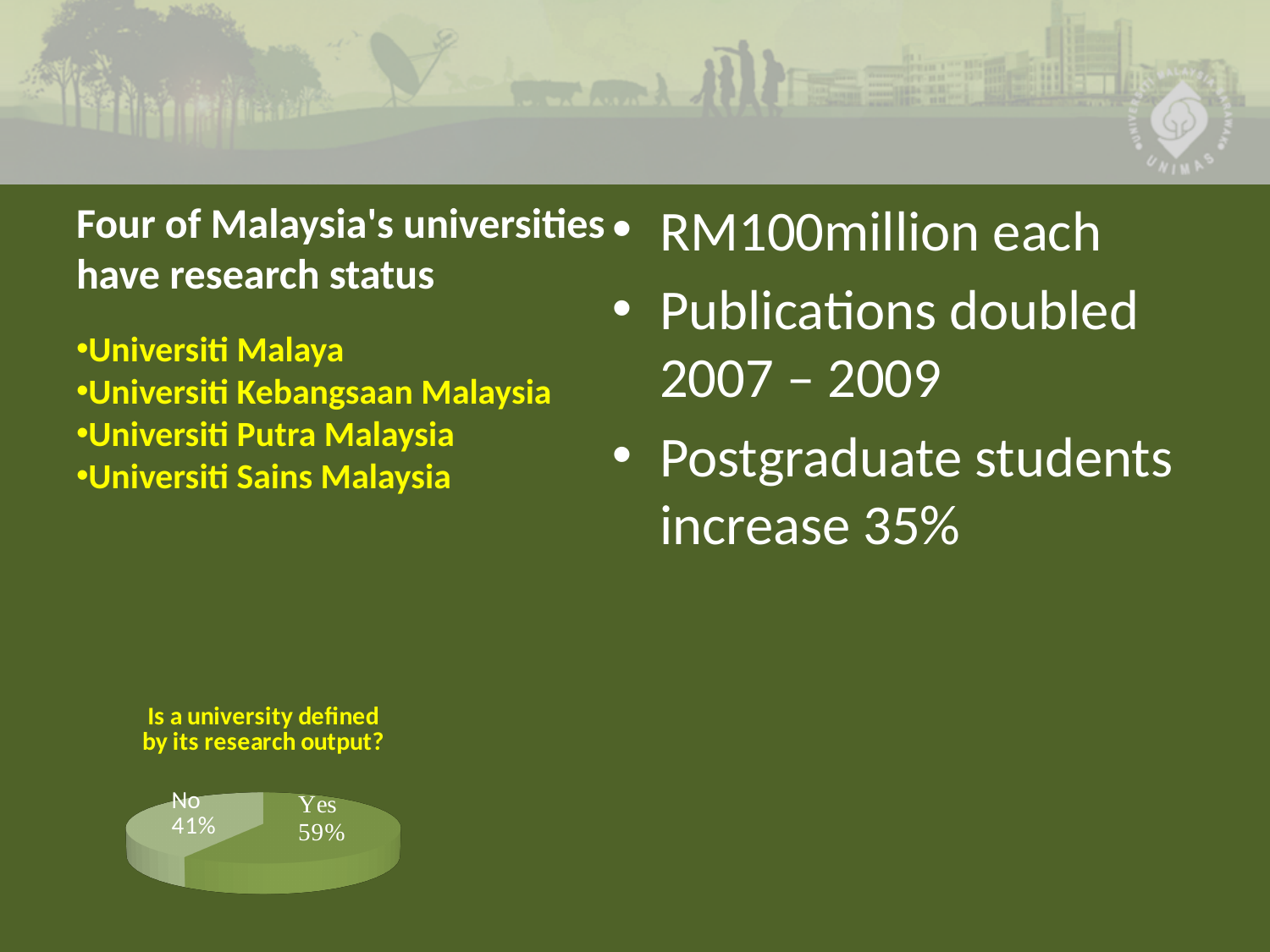
Which slice of the pie is the smallest? No How many slices does the pie chart have? 2 What is the title of the pie chart? Is a university defined by its research output? What is the difference in percentage points between the Yes and No slices? 18% Is the Yes share greater or less than 50%? greater What share of the pie is labelled Yes? 59% What share of the pie is labelled No? 41% Which is larger, the Yes slice or the No slice? Yes Is the No share greater or less than 50%? less Which slice of the pie is the largest? Yes What kind of chart is shown on the slide? pie chart